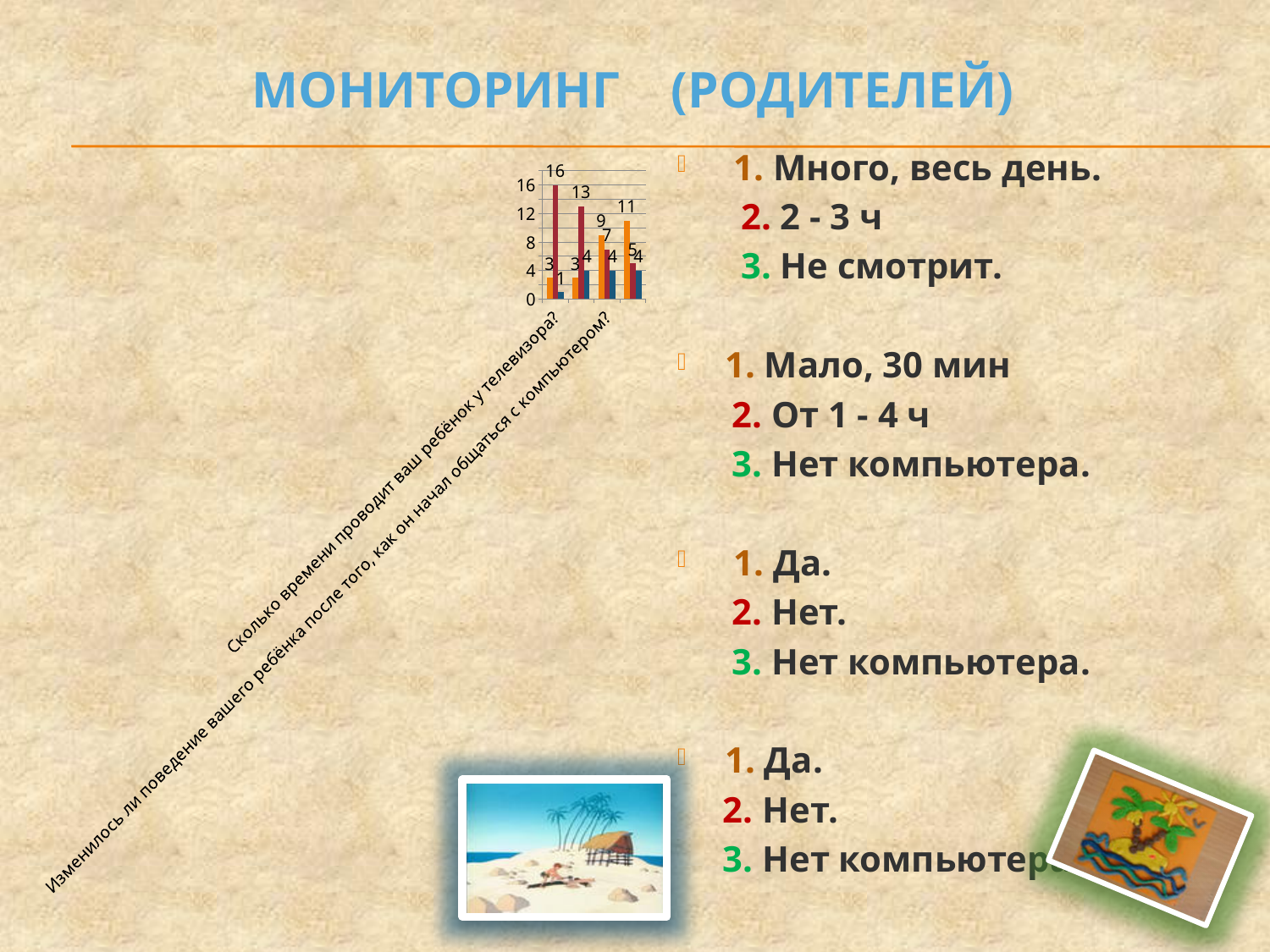
How many groups of bars does the chart contain? 4 What is the value of the tallest bar in the chart? 16 In the first group of bars, what is the value of the red (middle) bar? 16 What is the value of the shortest bar in the chart? 1 What kind of chart is shown on the slide? bar chart In the fourth (rightmost) group of bars, what is the value of the orange (first) bar? 11 What is the highest tick value shown on the vertical axis of the chart? 16 What is the difference between the two tallest red bars in the chart (labelled 16 and 13)? 3 Is the value of the red bar in the first group greater or less than 12? greater In the second group of bars, what is the value of the red (middle) bar? 13 How many bars are there in each group of the chart? 3 Which is larger in the third group of bars: the orange bar (9) or the red bar (7)? the orange bar (9)